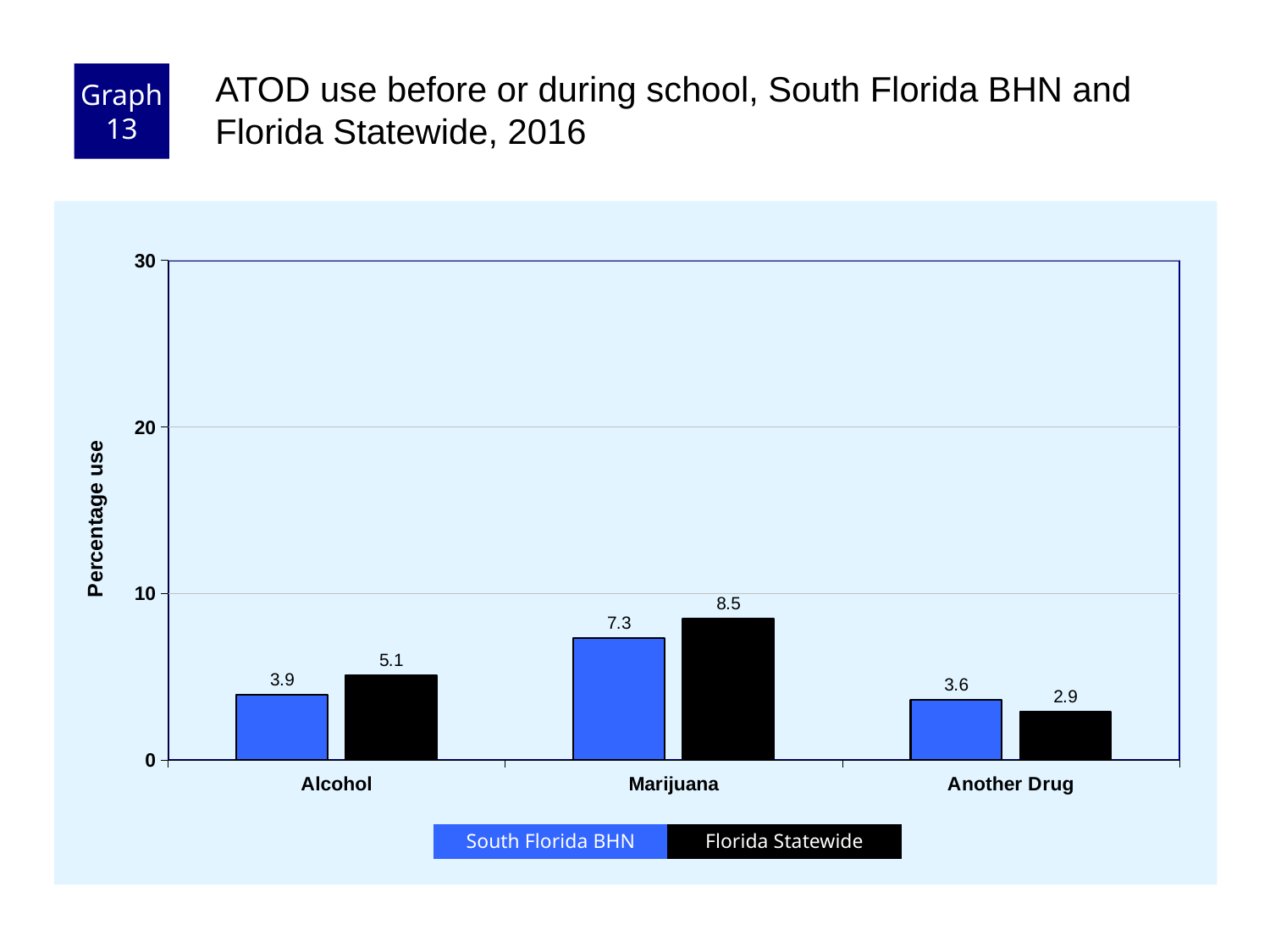
What is the Florida Statewide value for Another Drug? 2.9 What is the difference between the South Florida BHN and Florida Statewide values for Another Drug? 0.7 What is the difference between the Florida Statewide and South Florida BHN values for Marijuana? 1.2 How many categories are shown on the x axis? 3 Which category has the highest Florida Statewide value? Marijuana What kind of chart is shown on the slide? bar chart Which category has the lowest South Florida BHN value? Another Drug What is the South Florida BHN value for Marijuana? 7.3 Is the Florida Statewide value for Marijuana greater or less than 10? less What is the Florida Statewide value for Alcohol? 5.1 For Alcohol, which is larger: South Florida BHN or Florida Statewide? Florida Statewide How many series does the legend list? 2